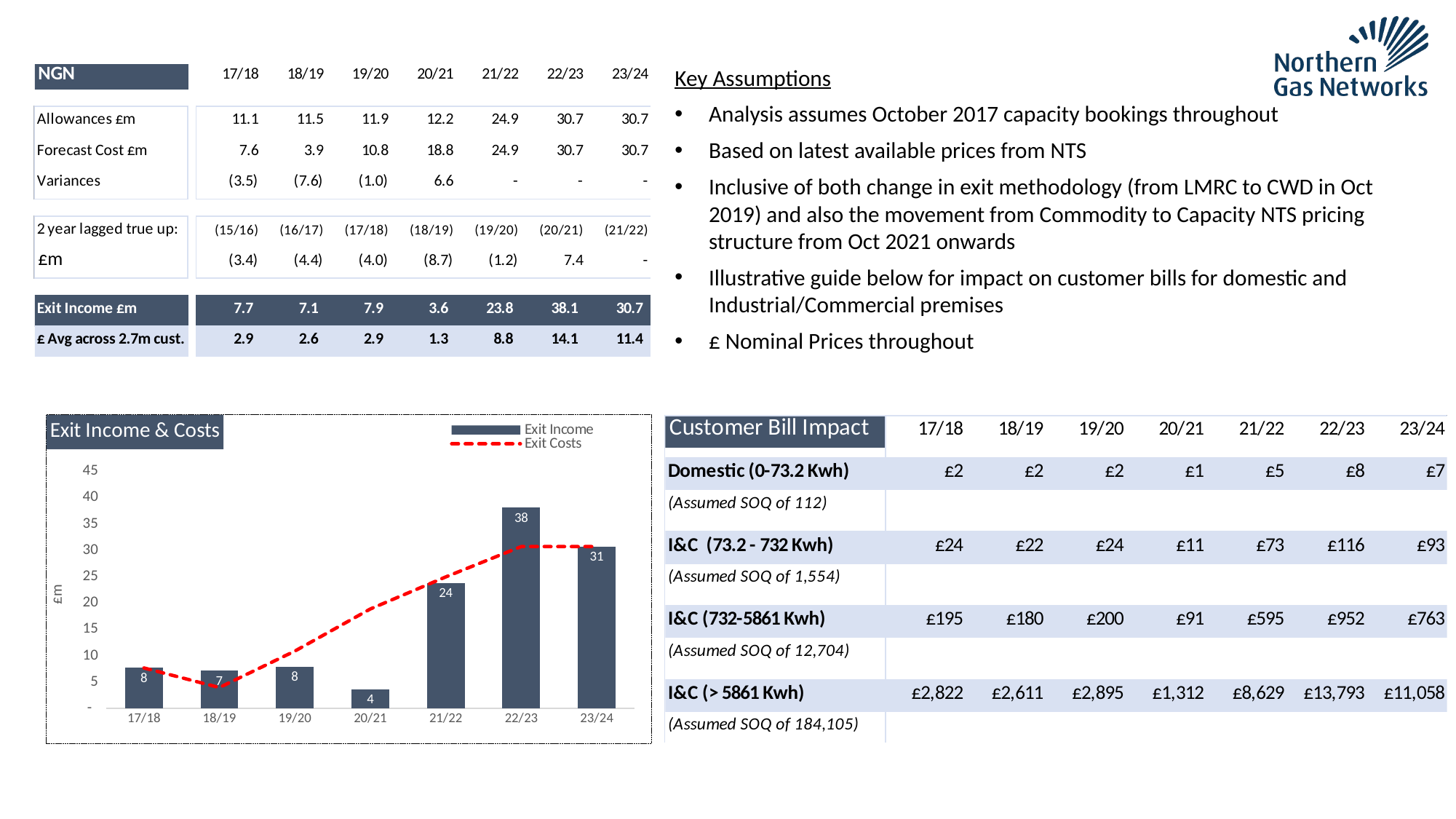
In the Exit Income & Costs chart, which is larger, the Exit Income for 21/22 or for 23/24? 23/24 In the Exit Income & Costs chart, what is the Exit Income value for 22/23? 38 How many series does the legend of the Exit Income & Costs chart list? 2 In the Exit Income & Costs chart, what is the Exit Income value for 20/21? 4 In the Exit Income & Costs chart, is the Exit Costs value for 18/19 greater or less than 10? less In the Exit Income & Costs chart, is the Exit Costs value for 22/23 greater or less than 25? greater In the Exit Income & Costs chart, which year has the lowest Exit Income? 20/21 In the Exit Income & Costs chart, what is the difference between the Exit Income for 22/23 and 23/24? 7 How many years are shown on the x axis of the Exit Income & Costs chart? 7 In the Exit Income & Costs chart, what is the Exit Income value for 23/24? 31 In the Exit Income & Costs chart, does Exit Income rise or fall from 20/21 to 22/23? rise In the Exit Income & Costs chart, which year has the highest Exit Income? 22/23